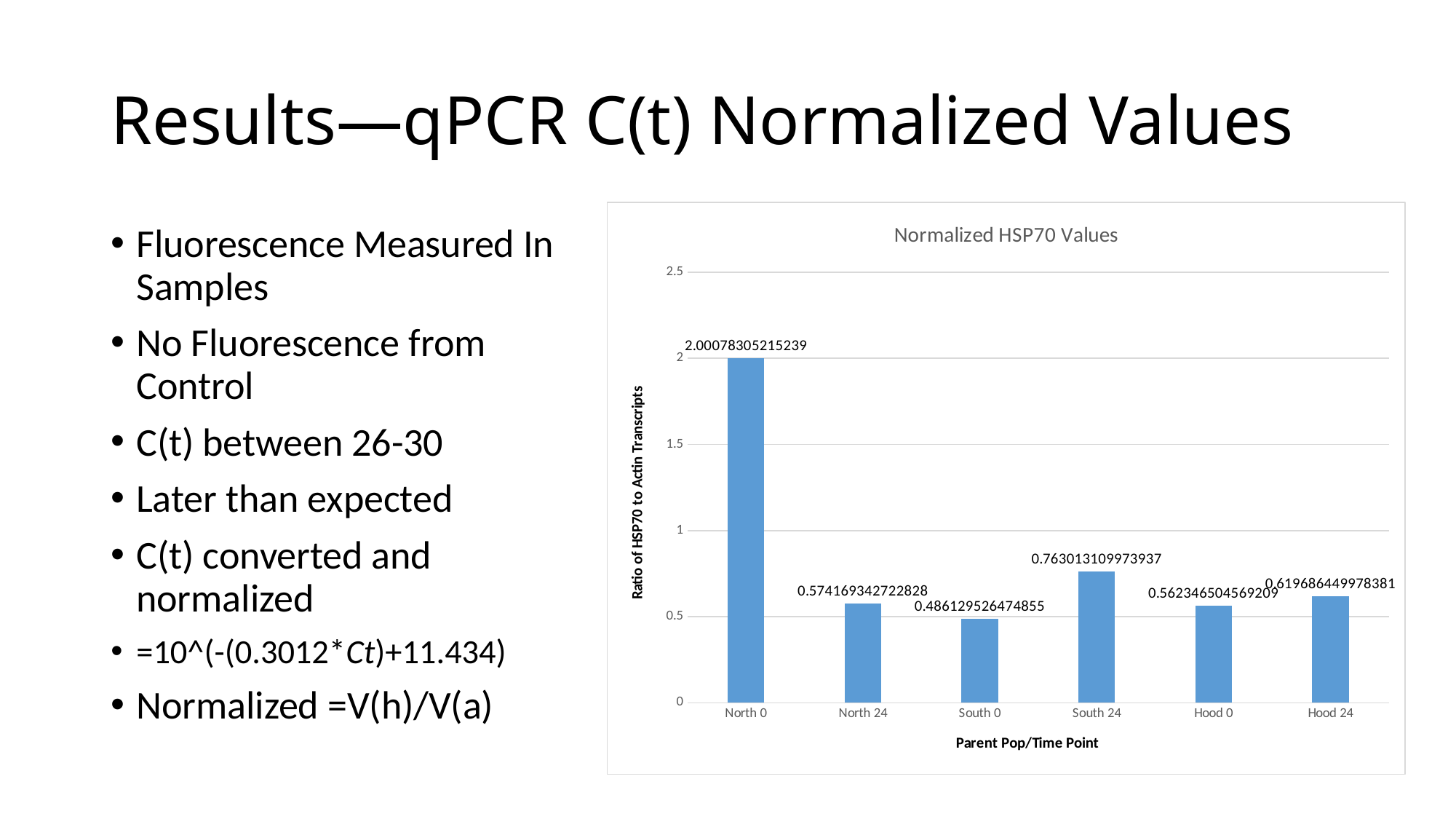
What kind of chart is the Normalized HSP70 Values chart? bar chart Is the value for North 0 greater or less than 1.5? greater What is the value for Hood 0 in the Normalized HSP70 Values chart? 0.562346504569209 Is the value for South 0 greater or less than 0.5? less Which is larger in the Normalized HSP70 Values chart, Hood 0 or Hood 24? Hood 24 Which category has the highest value in the Normalized HSP70 Values chart? North 0 What is the value for South 24 in the Normalized HSP70 Values chart? 0.763013109973937 What is the label of the x axis in the Normalized HSP70 Values chart? Parent Pop/Time Point Which is larger in the Normalized HSP70 Values chart, North 24 or South 24? South 24 Which category has the lowest value in the Normalized HSP70 Values chart? South 0 How many categories are shown on the x axis of the Normalized HSP70 Values chart? 6 What is the value for North 0 in the Normalized HSP70 Values chart? 2.00078305215239